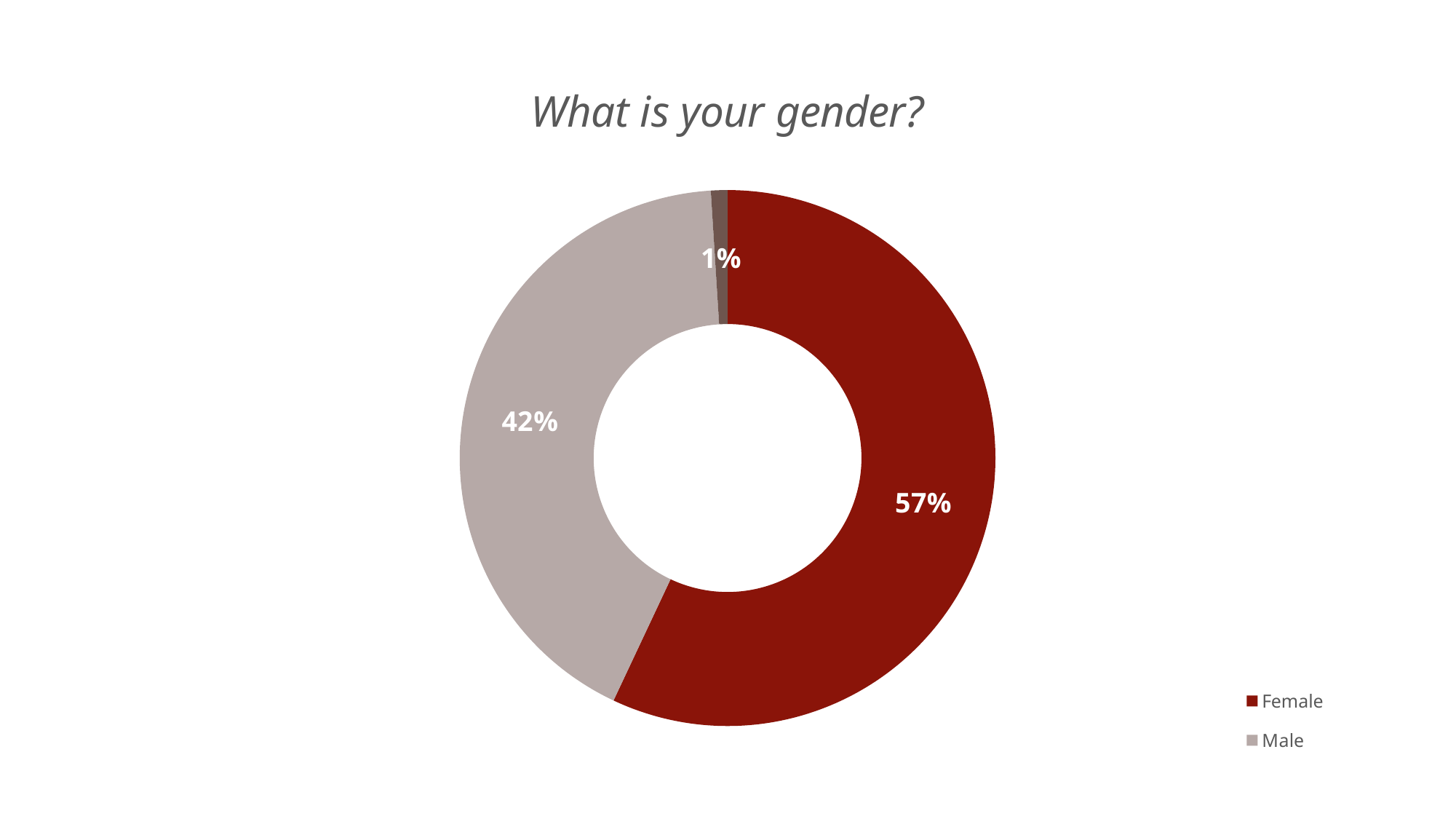
By how many percentage points does the Female share exceed the Male share? 15% Which is larger, the Female share or the Male share? Female What colour is the Female slice? Dark red How many slices does the chart have? 3 What percentage of respondents are Male? 42% What is the title of the chart? What is your gender? Is the Male share greater or less than 50%? less What kind of chart is shown on the slide? Pie (doughnut) chart How many entries does the legend list? 2 What percentage of respondents are Female? 57% Which legend category has the largest share of the chart? Female What is the smallest percentage value printed on the chart? 1%